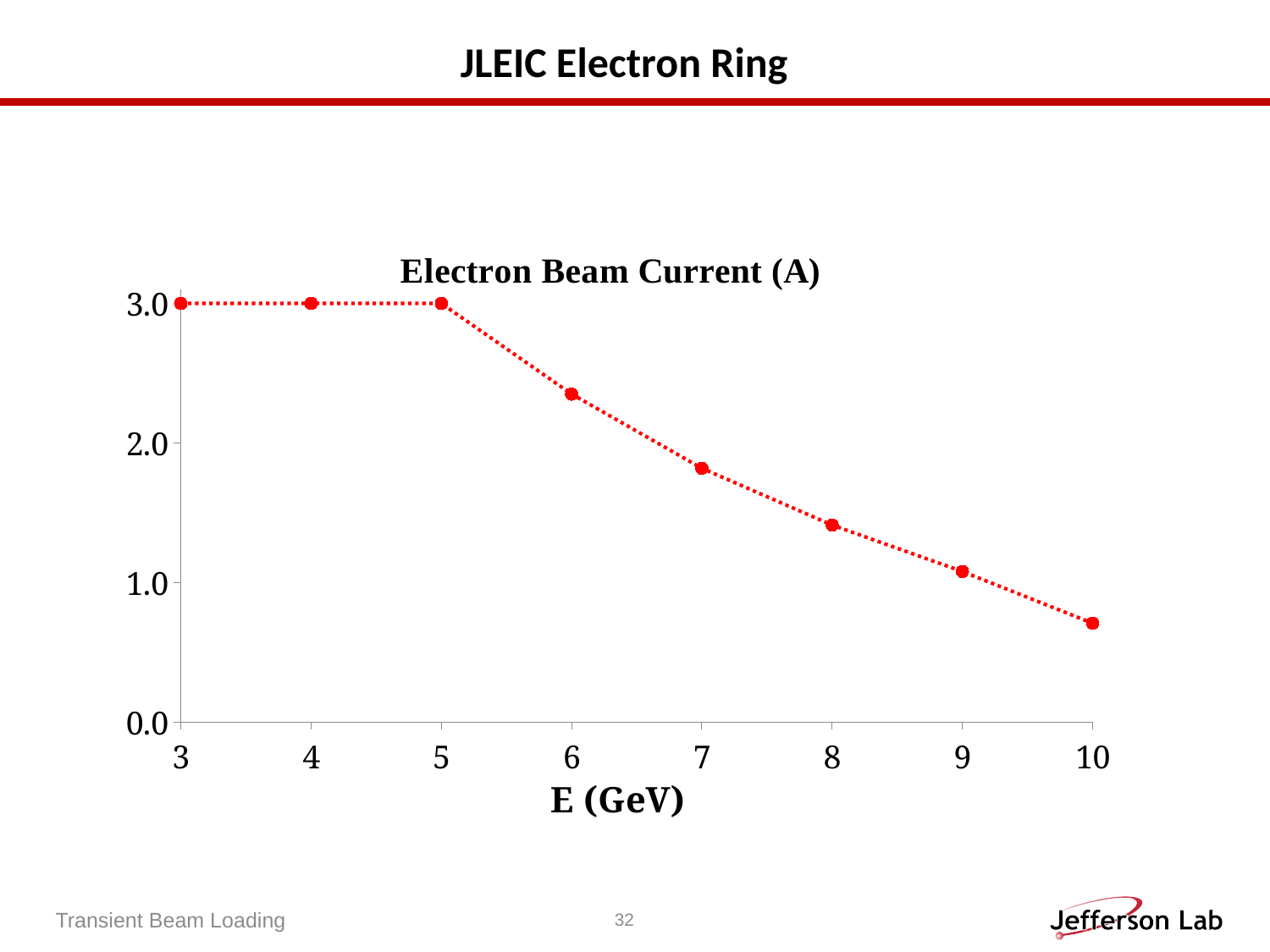
Is the value at E = 7 GeV greater or less than 2.0? less How many data points are plotted on the chart? 8 Which has the larger electron beam current, E = 6 GeV or E = 8 GeV? 6 GeV What is the electron beam current at E = 3 GeV? 3.0 Does the electron beam current rise or fall as energy increases from 5 GeV to 10 GeV? fall At which energy is the electron beam current lowest? 10 What is the title of the chart? Electron Beam Current (A) What type of chart is shown on the slide? line chart Is the value at E = 6 GeV greater or less than 2.0? greater Is the value at E = 10 GeV greater or less than 1.0? less What is the electron beam current at E = 5 GeV? 3.0 What is the label of the x axis? E (GeV)